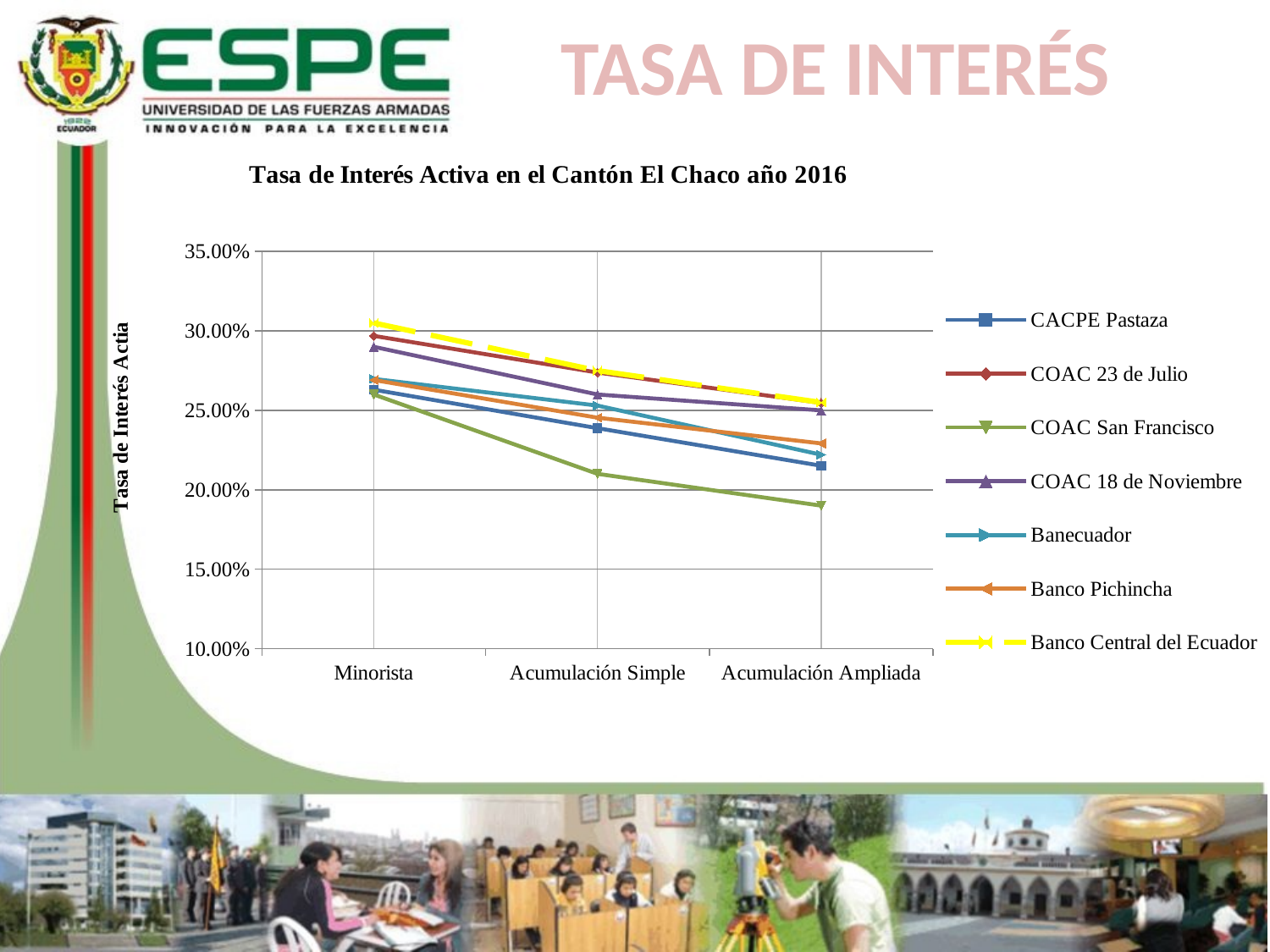
What is the label of the vertical axis? Tasa de Interés Actia At Acumulación Simple, which is larger: COAC San Francisco or COAC 18 de Noviembre? COAC 18 de Noviembre What is the title of the chart? Tasa de Interés Activa en el Cantón El Chaco año 2016 Is the value for COAC 18 de Noviembre at Minorista greater or less than 30.00%? less How many series does the legend list? 7 Is the value for Banco Central del Ecuador at Minorista greater or less than 30.00%? greater How many categories are shown on the x axis? 3 What kind of chart is shown on the slide? Line chart Do the values for COAC San Francisco rise or fall from Minorista to Acumulación Ampliada? Fall Which series has the lowest value at Acumulación Ampliada? COAC San Francisco Is the value for COAC San Francisco at Acumulación Ampliada greater or less than 20.00%? less